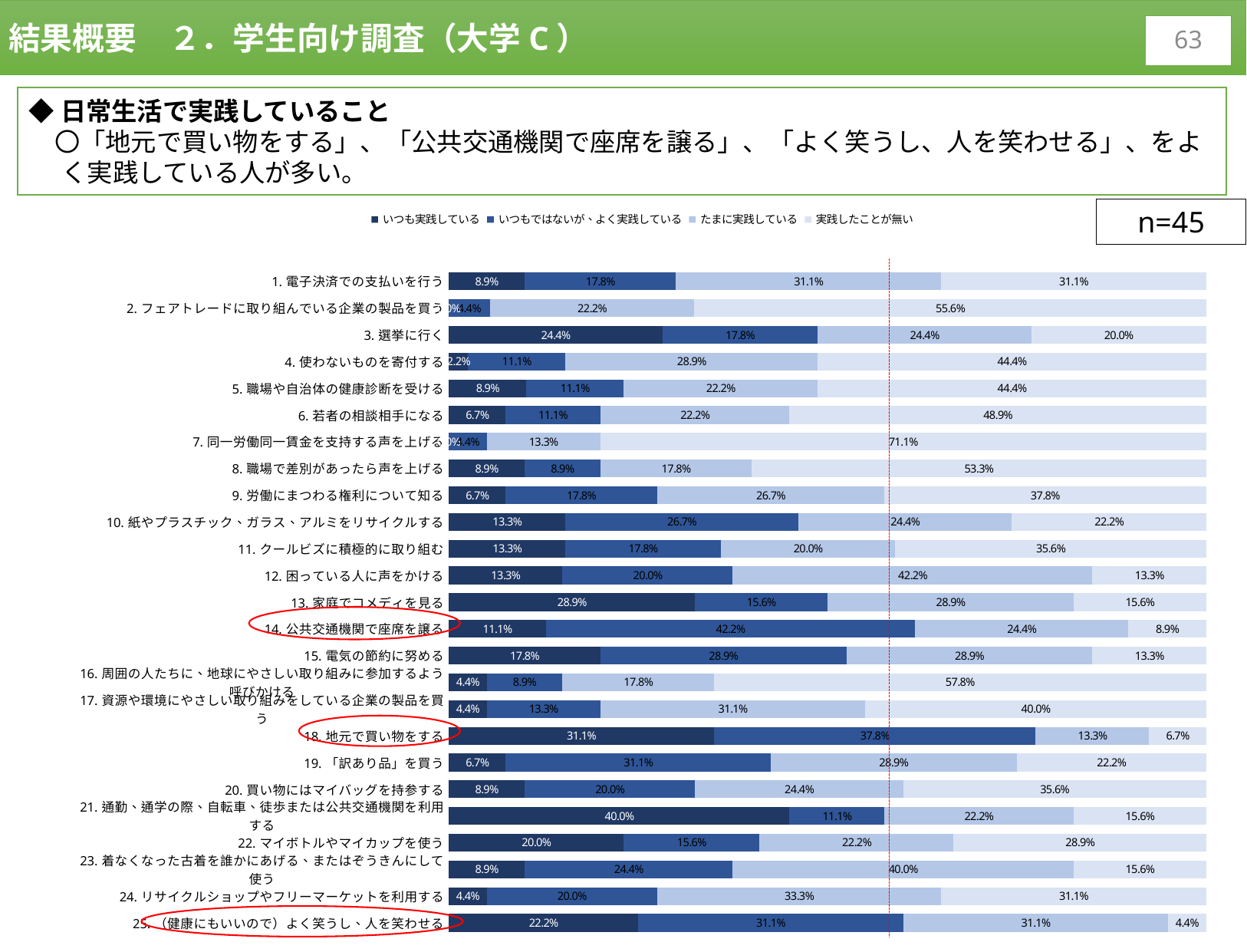
What is the value of 「いつもではないが、よく実践している」 for item 14 (公共交通機関で座席を譲る)? 42.2% What is the sample size (n) shown on the slide? n=45 How many series does the legend list? 4 How many categories (items) are plotted in the chart? 25 What is the value of 「いつも実践している」 for item 21 (通勤、通学の際、自転車、徒歩または公共交通機関を利用する)? 40.0% Which item has the lowest value for 「実践したことが無い」? 25. （健康にもいいので）よく笑うし、人を笑わせる Which is larger: the 「いつも実践している」 value for item 18 (地元で買い物をする) or for item 13 (家庭でコメディを見る)? 18. 地元で買い物をする What is the value of 「たまに実践している」 for item 12 (困っている人に声をかける)? 42.2% What is the value of 「実践したことが無い」 for item 7 (同一労働同一賃金を支持する声を上げる)? 71.1% Which item has the highest value for 「いつも実践している」? 21. 通勤、通学の際、自転車、徒歩または公共交通機関を利用する For item 1 (電子決済での支払いを行う), what is the difference between 「実践したことが無い」 (31.1%) and 「いつも実践している」 (8.9%)? 22.2% What type of chart is shown on the slide? Stacked bar chart